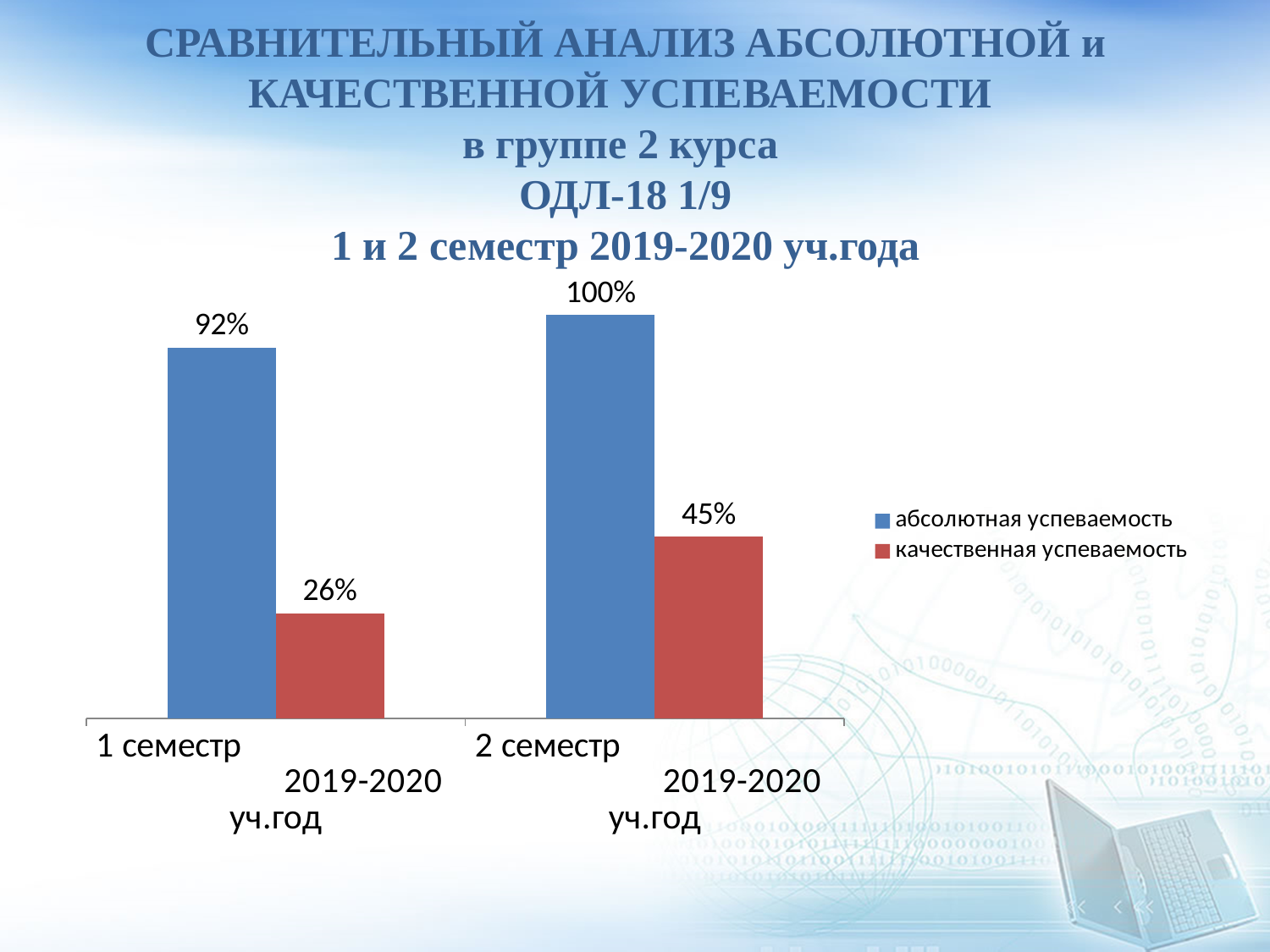
What is the difference between абсолютная and качественная успеваемость in 2 семестр? 55 What is the абсолютная успеваемость value for 2 семестр 2019-2020 уч.год? 100% How many series does the legend list? 2 What is the абсолютная успеваемость value for 1 семестр 2019-2020 уч.год? 92% By how many percentage points did качественная успеваемость increase from 1 семестр to 2 семестр? 19 What is the качественная успеваемость value for 1 семестр 2019-2020 уч.год? 26% Which is larger: абсолютная успеваемость in 1 семестр or качественная успеваемость in 2 семестр? абсолютная успеваемость in 1 семестр What is the качественная успеваемость value for 2 семестр 2019-2020 уч.год? 45% Which colour represents качественная успеваемость in the legend? red In which semester is качественная успеваемость highest? 2 семестр 2019-2020 уч.год What kind of chart is shown on the slide? bar chart In which semester is абсолютная успеваемость lowest? 1 семестр 2019-2020 уч.год